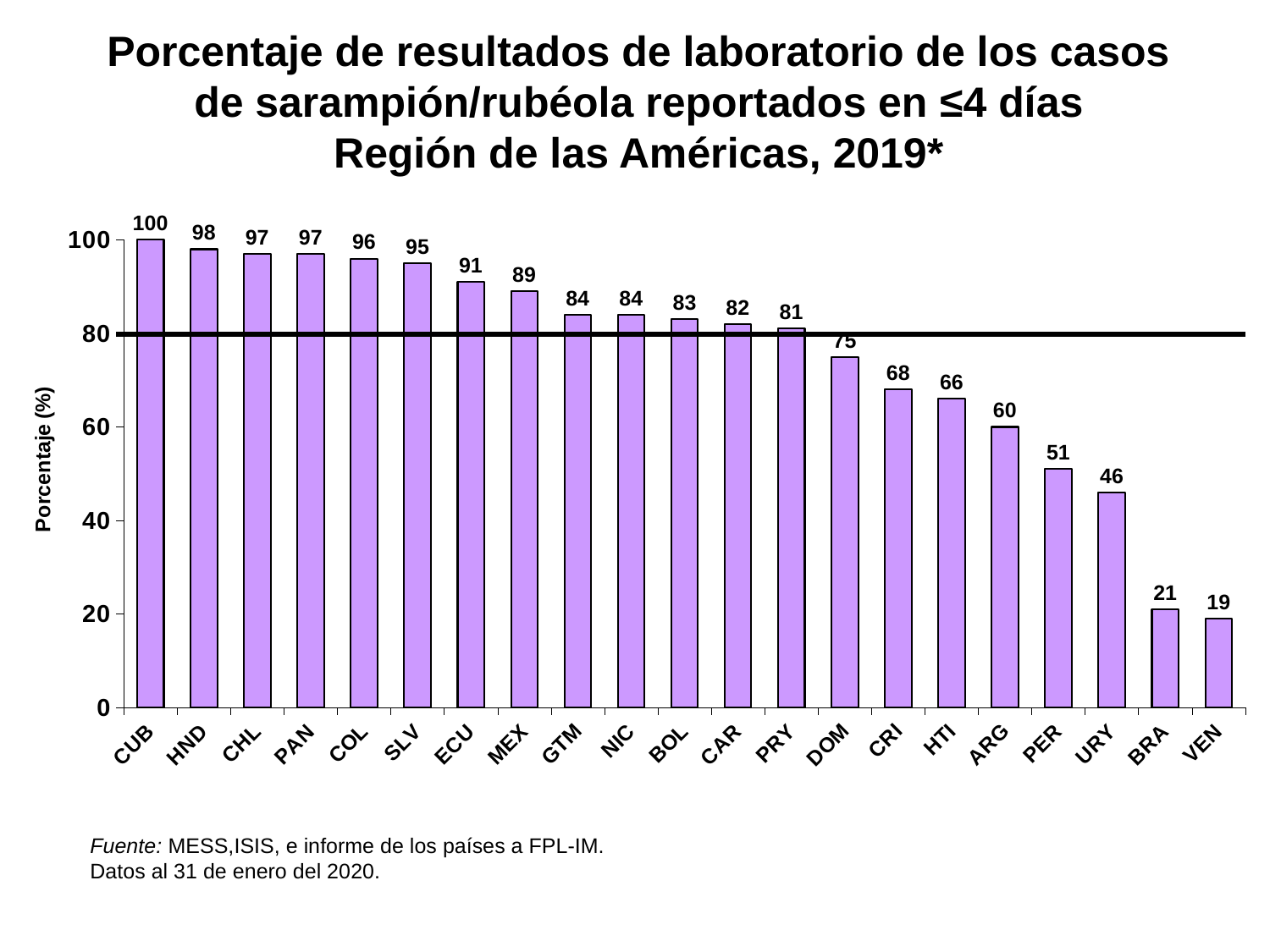
Do the values rise or fall from left to right along the x axis? fall What kind of chart is shown? bar chart What is the difference between the values for CUB and VEN? 81 Which has a larger value, ARG or URY? ARG What is the value for PER? 51 Which country has the highest value? CUB What is the difference between the values for ECU and CRI? 23 How many countries are shown on the x axis? 21 Is the value for HTI greater or less than 80? less What is the value for DOM? 75 Which country has the lowest value? VEN What is the value for MEX? 89